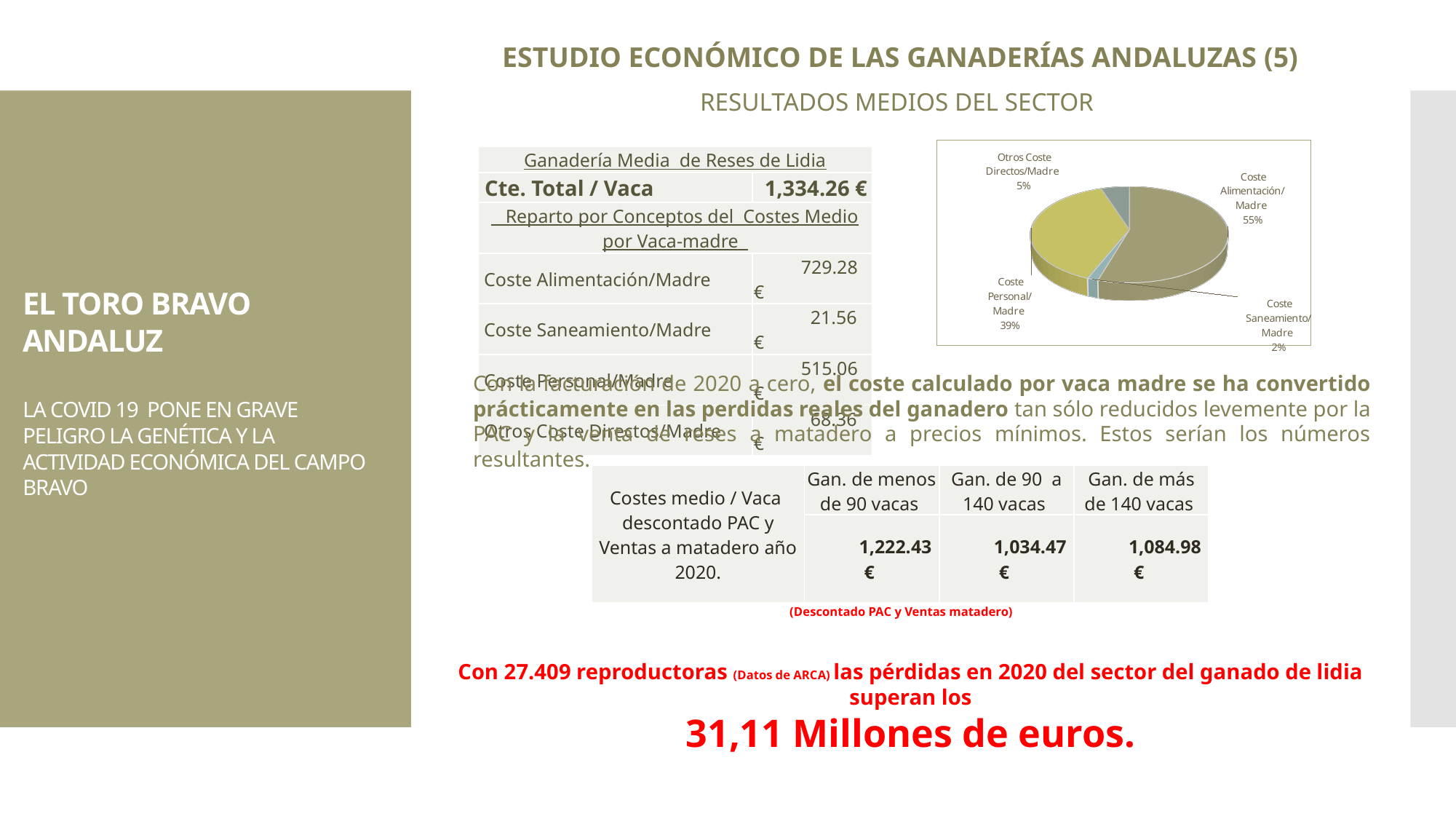
What kind of chart is shown on the slide? pie chart What is the difference in percentage points between Coste Alimentación/Madre and Coste Personal/Madre in the pie chart? 16 How many slices does the pie chart have? 4 In the pie chart, what share does Otros Coste Directos/Madre have? 5% In the pie chart, what share does Coste Personal/Madre have? 39% In the pie chart, which is larger: Otros Coste Directos/Madre or Coste Saneamiento/Madre? Otros Coste Directos/Madre What is the combined share of Coste Alimentación/Madre and Coste Personal/Madre in the pie chart? 94% In the pie chart, what share does Coste Saneamiento/Madre have? 2% Which slice of the pie chart is the largest? Coste Alimentación/Madre Is the pie chart drawn in 3D or flat 2D? 3D Which slice of the pie chart is the smallest? Coste Saneamiento/Madre